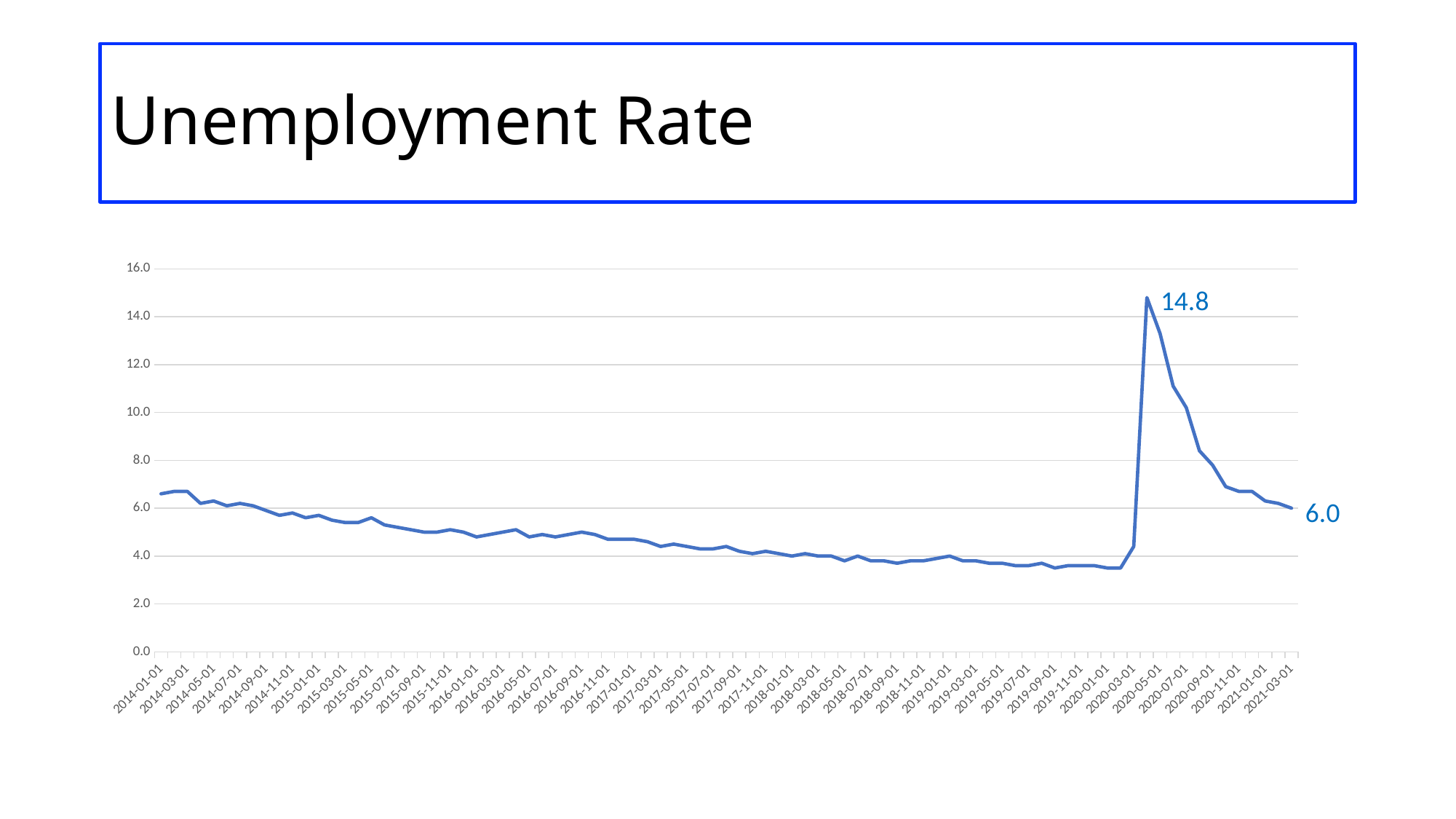
Is the peak value in 2020 greater or less than 14.0? greater Is the value at 2014-01-01 greater or less than 6.0? greater Which is larger, the value at 2014-01-01 or the value at 2019-01-01? 2014-01-01 What kind of chart is shown on the slide? line chart What is the title of the slide? Unemployment Rate What is the highest value shown on the vertical axis? 16.0 Does the unemployment rate generally rise or fall from 2014-01-01 to 2020-01-01? fall What is the difference between the peak value of 14.8 and the final value of 6.0? 8.8 Is the value at 2016-01-01 greater or less than 6.0? less What is the highest value labelled on the line? 14.8 What is the value labelled at the end of the line, at 2021-03-01? 6.0